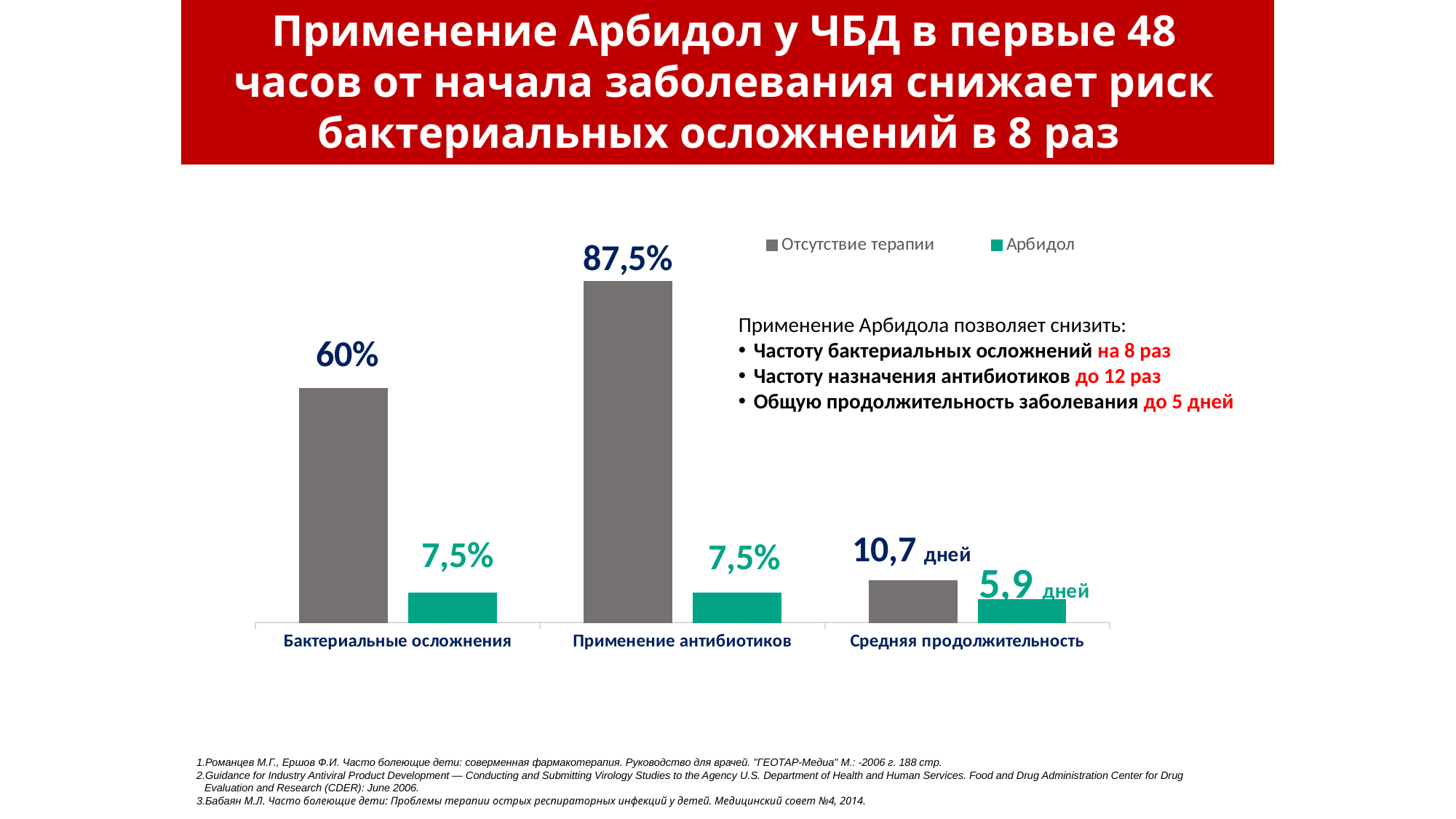
How many categories are shown on the x axis of the chart? 3 What is the value for "Отсутствие терапии" in the "Средняя продолжительность" category? 10,7 дней What is the difference between the "Отсутствие терапии" and "Арбидол" values in the "Бактериальные осложнения" category? 52,5% Which category has the highest value for the "Отсутствие терапии" series? Применение антибиотиков How many series does the chart legend list? 2 What type of chart is shown on the slide? Bar chart What is the value for "Арбидол" in the "Применение антибиотиков" category? 7,5% What is the value for "Отсутствие терапии" in the "Бактериальные осложнения" category? 60% What is the value for "Арбидол" in the "Средняя продолжительность" category? 5,9 дней What is the difference between the "Отсутствие терапии" and "Арбидол" values in the "Применение антибиотиков" category? 80% Which colour represents the "Арбидол" series in the chart? Green Which is larger in the "Средняя продолжительность" category: "Отсутствие терапии" or "Арбидол"? Отсутствие терапии